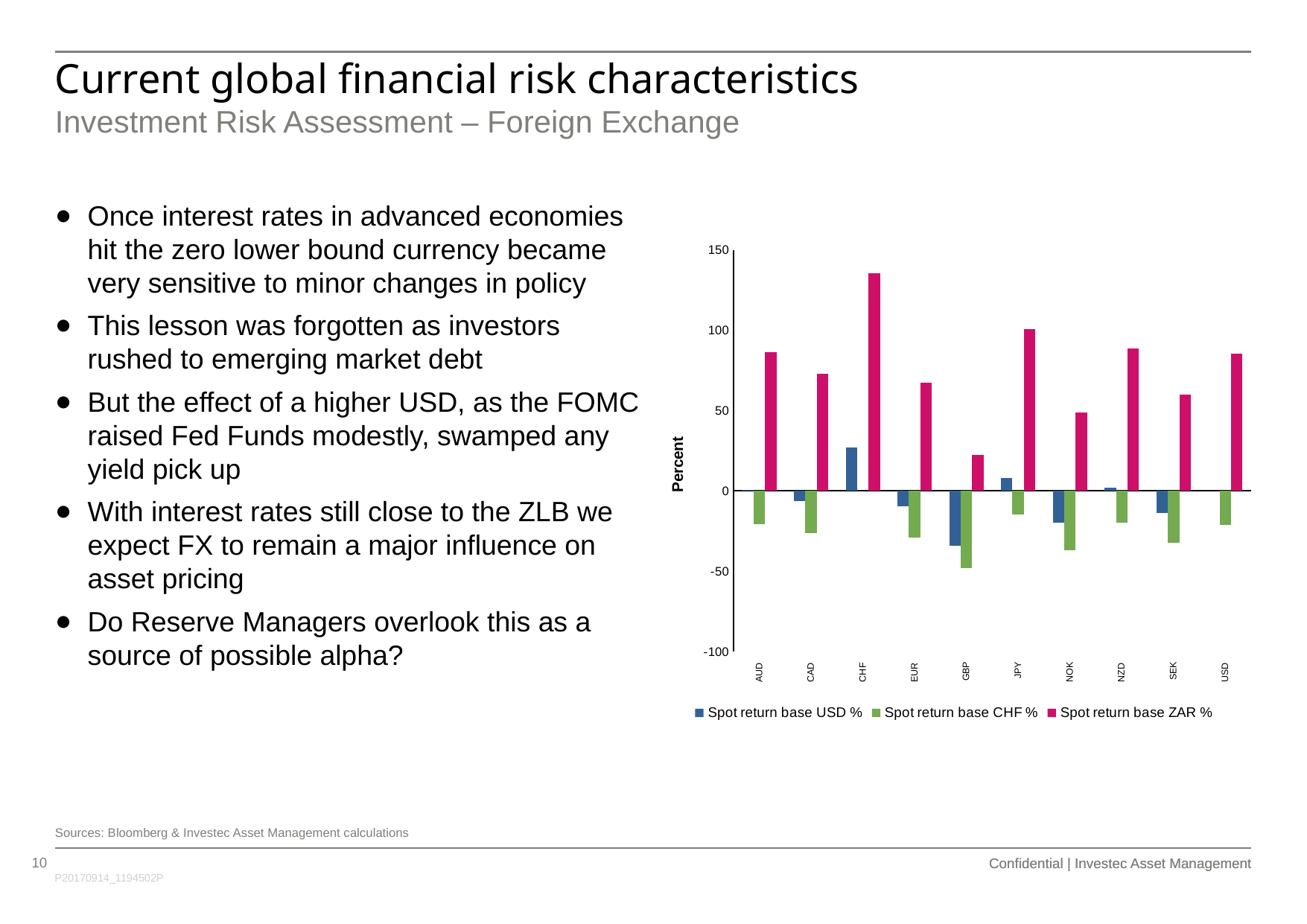
Which currency has the highest value for the Spot return base ZAR % series? CHF Which currency has the lowest value for the Spot return base USD % series? GBP Which currency has the highest value for the Spot return base USD % series? CHF How many currencies are shown on the x axis of the chart? 10 Is the Spot return base ZAR % value for GBP greater or less than 50? less Which currency has the lowest value for the Spot return base ZAR % series? GBP How many series does the chart legend list? 3 What kind of chart is shown on the slide? bar chart What is the label on the vertical axis of the chart? Percent Is the Spot return base CHF % value for NOK greater or less than -50? greater For the Spot return base ZAR % series, which is larger: the value for CHF or the value for JPY? CHF Is the Spot return base ZAR % value for CHF greater or less than 100? greater